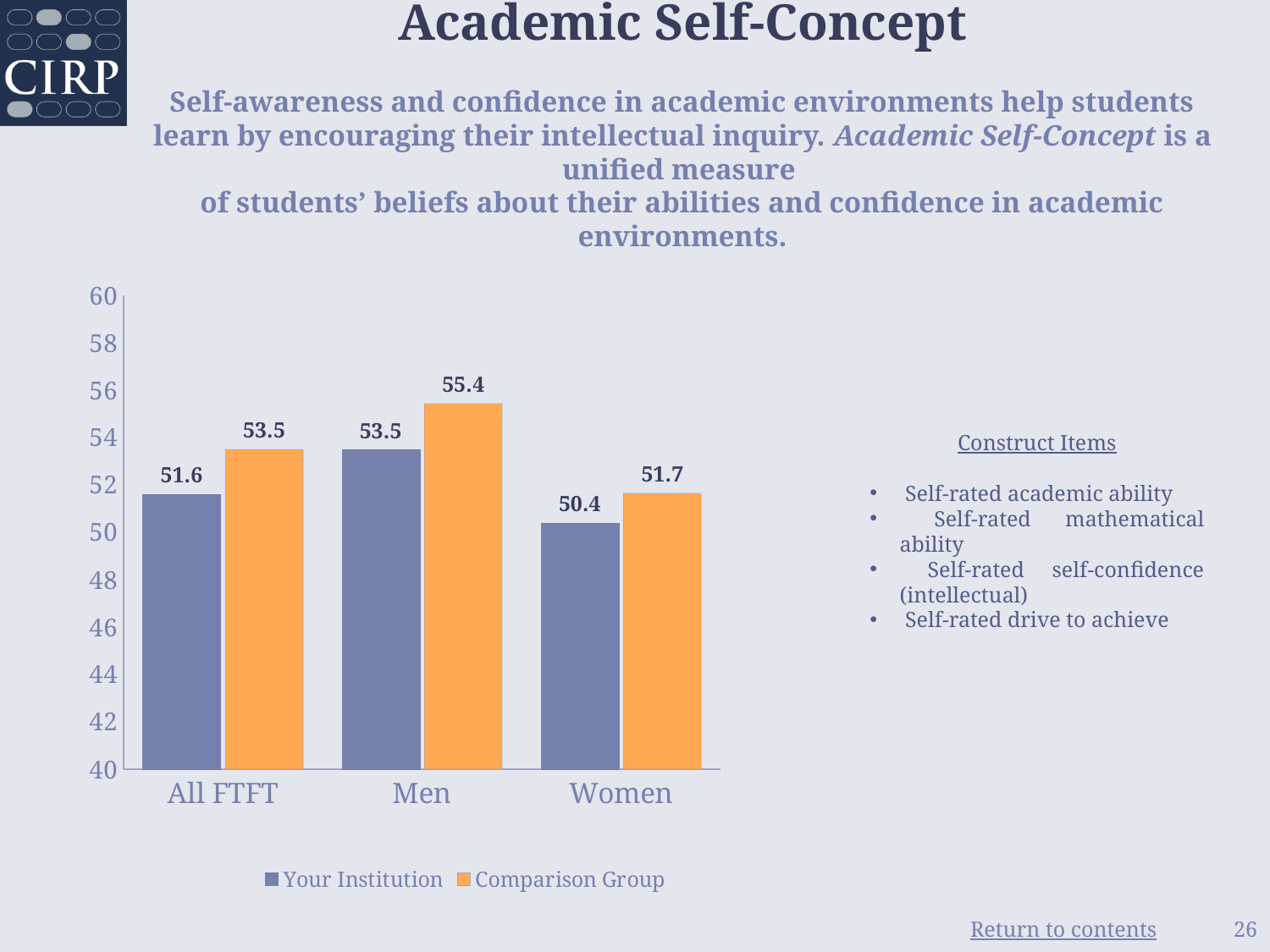
What is the difference between the Comparison Group and Your Institution values for All FTFT? 1.9 How many categories are shown on the x axis? 3 Which category has the lowest Your Institution value? Women What is the Your Institution value for Men? 53.5 How many series does the legend list? 2 What is the difference between the Comparison Group and Your Institution values for Men? 1.9 What kind of chart is shown on the slide? Bar chart What is the Your Institution value for All FTFT? 51.6 What is the Comparison Group value for Women? 51.7 Which category has the highest Comparison Group value? Men Which series is shown in orange in the legend? Comparison Group For Women, which is larger: Your Institution or Comparison Group? Comparison Group